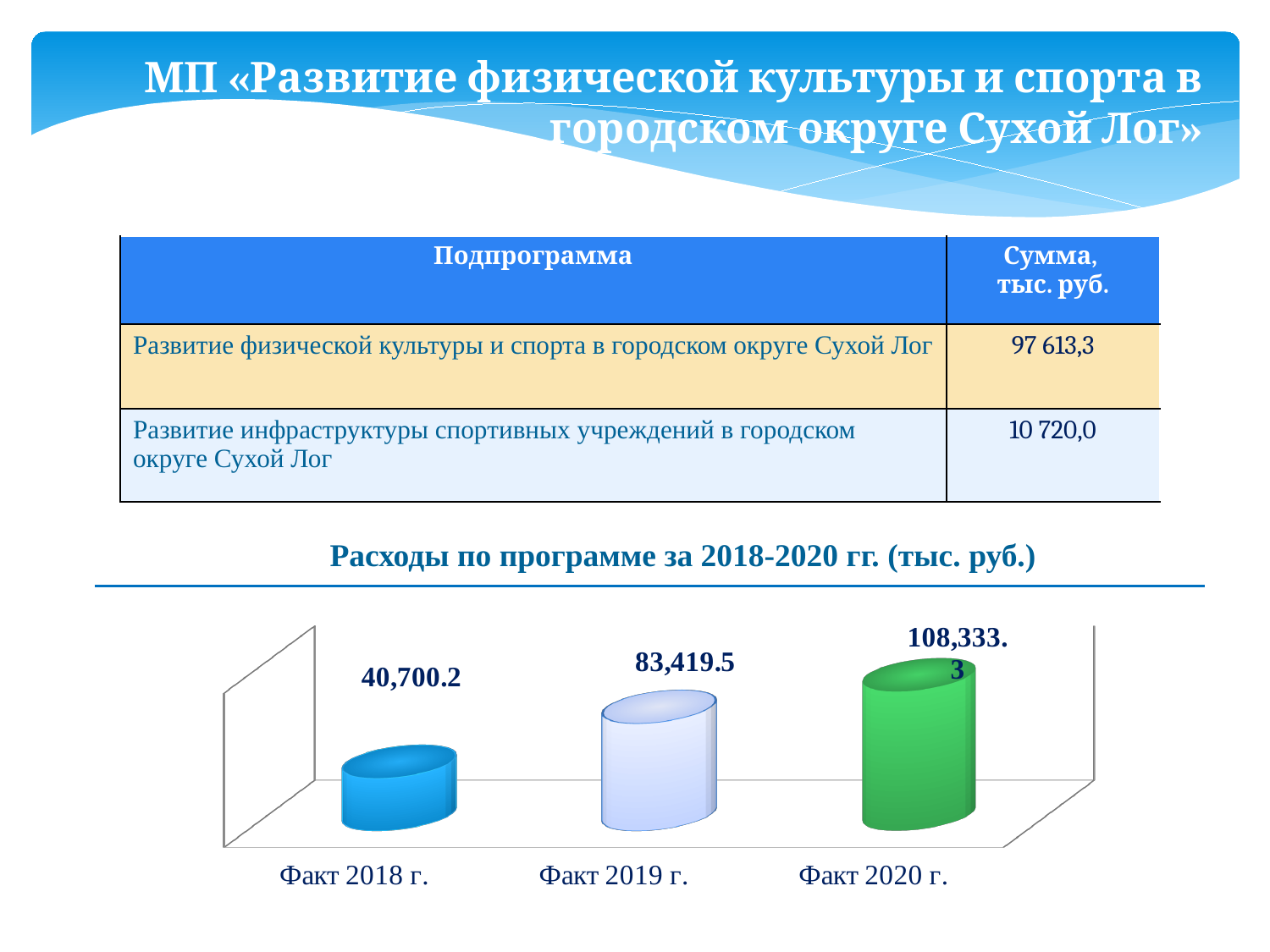
What kind of chart is shown on the slide? Bar chart What is the difference between the values for Факт 2020 г. and Факт 2018 г.? 67,633.1 Do the values rise or fall from Факт 2018 г. to Факт 2020 г.? Rise What is the difference between the values for Факт 2020 г. and Факт 2019 г.? 24,913.8 What is the value for Факт 2020 г.? 108,333.3 How many categories are shown in the chart? 3 Which is larger, the value for Факт 2019 г. or Факт 2018 г.? Факт 2019 г. What is the value for Факт 2019 г.? 83,419.5 What is the difference between the values for Факт 2019 г. and Факт 2018 г.? 42,719.3 Which category has the highest value? Факт 2020 г. Which category has the lowest value? Факт 2018 г. What is the value for Факт 2018 г.? 40,700.2